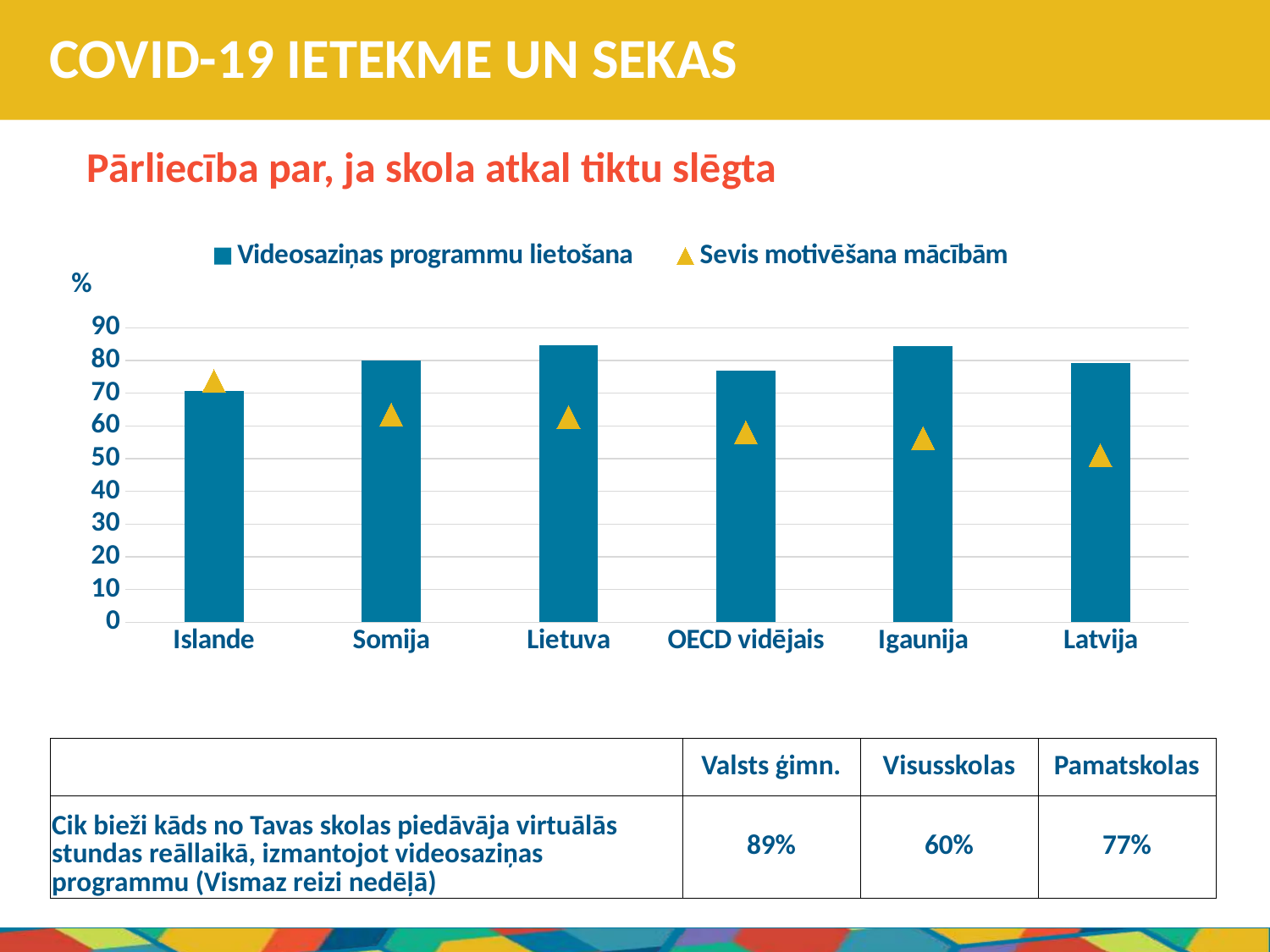
Which category has the lowest value for 'Sevis motivēšana mācībām'? Latvija Is the 'Videosaziņas programmu lietošana' value for Lietuva greater or less than 80? greater Which has the larger 'Videosaziņas programmu lietošana' value, Islande or Somija? Somija Is the 'Videosaziņas programmu lietošana' value for OECD vidējais greater or less than 80? less How many categories are shown on the x axis of the chart? 6 How many series does the chart legend list? 2 Which category has the highest value for 'Sevis motivēšana mācībām'? Islande What is the title shown above the chart? Pārliecība par, ja skola atkal tiktu slēgta Which category has the lowest bar for 'Videosaziņas programmu lietošana'? Islande Do the 'Sevis motivēšana mācībām' values rise or fall from Islande to Latvija along the x axis? fall Is the 'Sevis motivēšana mācībām' value for Latvija greater or less than 60? less What kind of chart is used to show the 'Videosaziņas programmu lietošana' series? bar chart